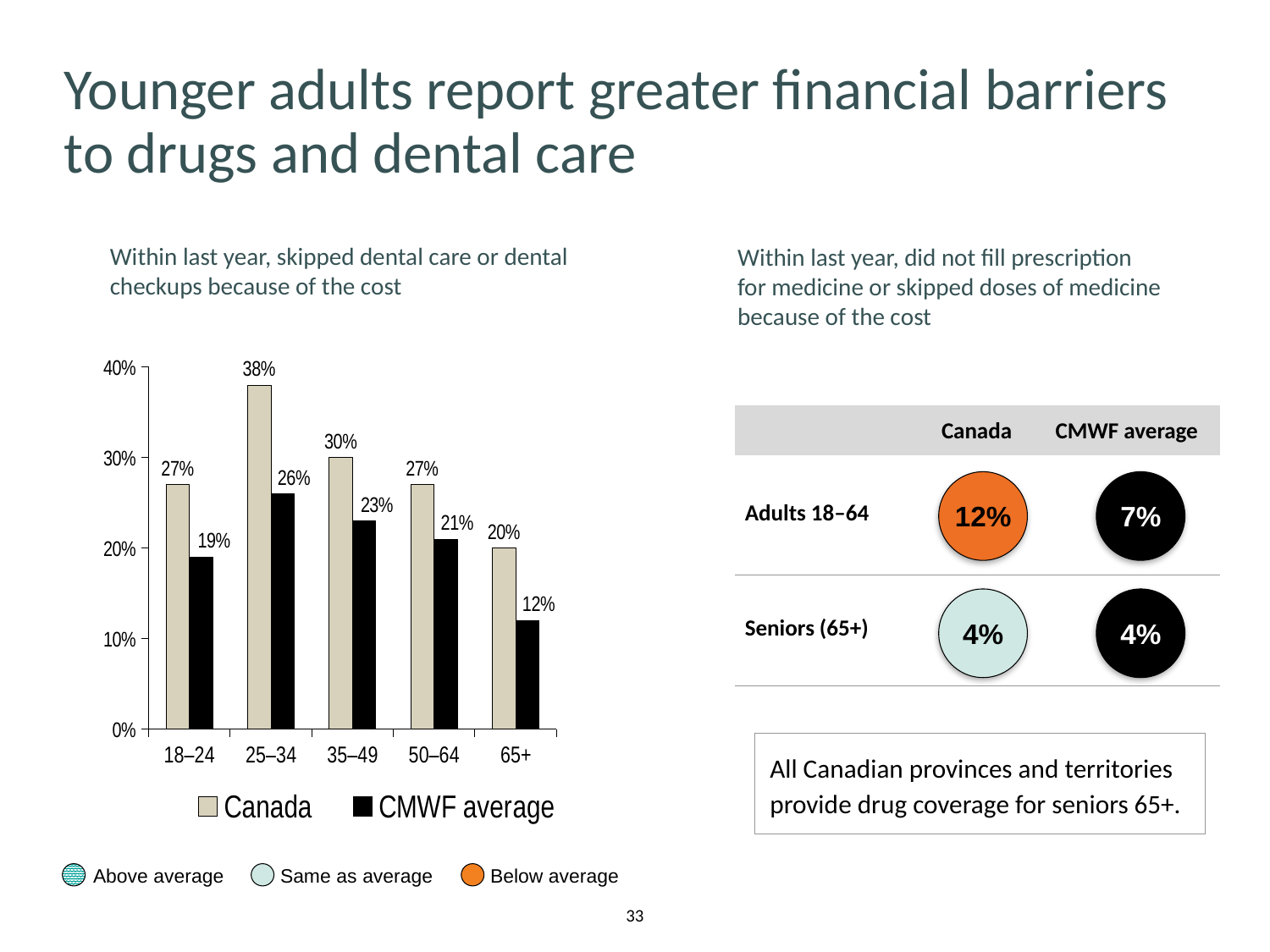
What type of chart is used to show skipped dental care by age group? Bar chart In the bar chart on skipped dental care, what is the Canada value for the 25–34 age group? 38% In the bar chart on skipped dental care, which age group has the highest Canada value? 25–34 In the bar chart on skipped dental care, what is the difference between the Canada and CMWF average values for the 25–34 age group? 12% In the bar chart on skipped dental care, what is the CMWF average value for the 35–49 age group? 23% How many series does the legend of the bar chart on skipped dental care list? 2 In the bar chart on skipped dental care, which age group has the lowest CMWF average value? 65+ In the bar chart on skipped dental care, which is larger for the 50–64 age group: the Canada value or the CMWF average value? Canada In the bar chart on skipped dental care, what is the difference between the Canada values for the 18–24 and 65+ age groups? 7% In the bar chart on skipped dental care, is the Canada value for the 35–49 age group greater or less than 20%? greater In the bar chart on skipped dental care, what is the CMWF average value for the 65+ age group? 12% How many age groups are shown in the bar chart on skipped dental care? 5